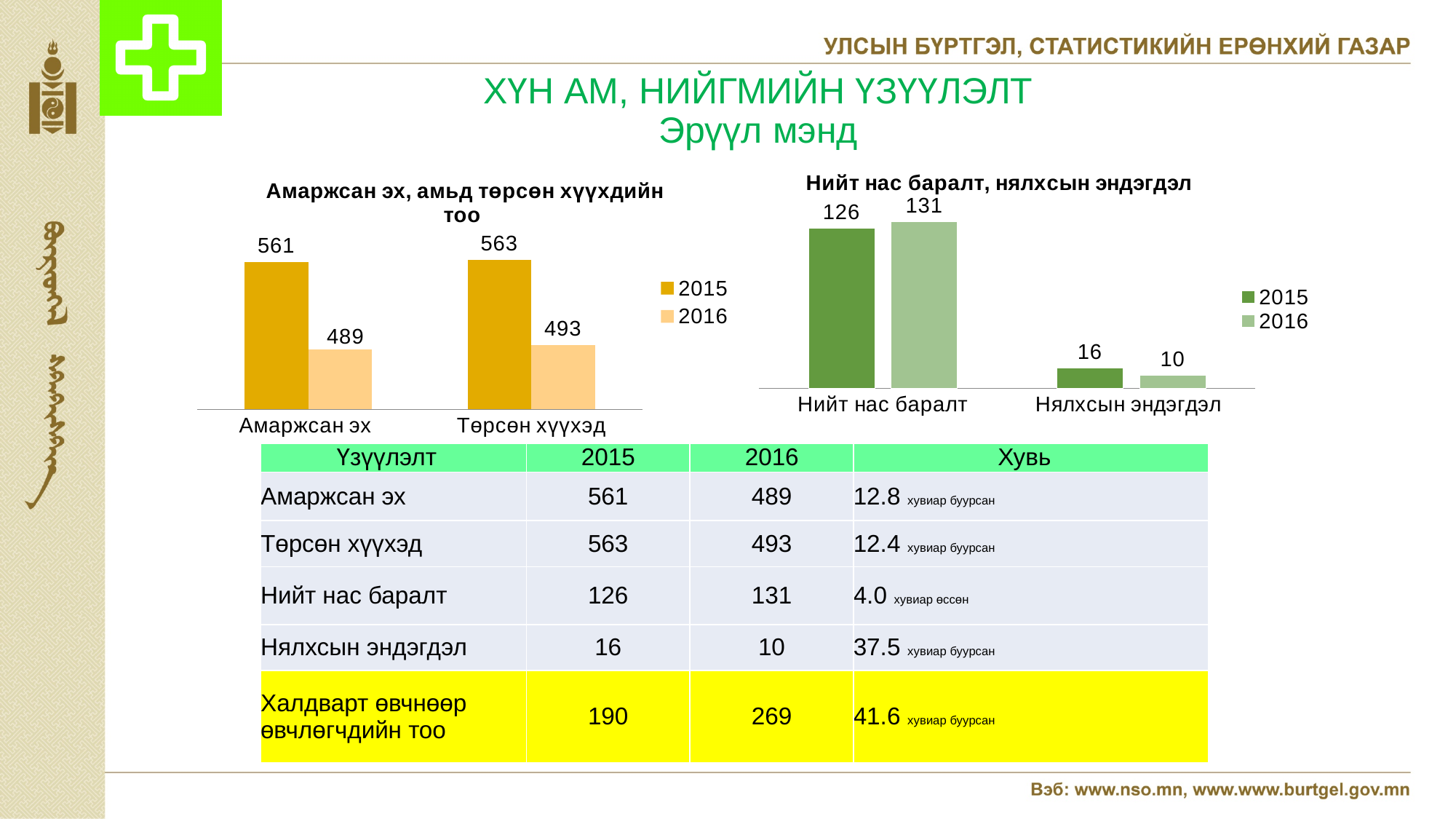
In the left chart (Амаржсан эх, амьд төрсөн хүүхдийн тоо), what is the difference between the 2015 and 2016 values for Амаржсан эх? 72 In the left chart (Амаржсан эх, амьд төрсөн хүүхдийн тоо), how many series does the legend list? 2 In the right chart (Нийт нас баралт, нялхсын эндэгдэл), what is the 2016 value for Нийт нас баралт? 131 In the left chart (Амаржсан эх, амьд төрсөн хүүхдийн тоо), what is the 2015 value for Амаржсан эх? 561 In the right chart (Нийт нас баралт, нялхсын эндэгдэл), what is the 2015 value for Нялхсын эндэгдэл? 16 What kind of chart is the right chart (Нийт нас баралт, нялхсын эндэгдэл)? Bar chart In the right chart (Нийт нас баралт, нялхсын эндэгдэл), which category has the highest 2016 value? Нийт нас баралт In the right chart (Нийт нас баралт, нялхсын эндэгдэл), how many categories are shown on the x axis? 2 In the left chart (Амаржсан эх, амьд төрсөн хүүхдийн тоо), which is larger for Төрсөн хүүхэд: the 2015 value or the 2016 value? 2015 In the right chart (Нийт нас баралт, нялхсын эндэгдэл), what is the difference between the 2015 and 2016 values for Нялхсын эндэгдэл? 6 In the left chart (Амаржсан эх, амьд төрсөн хүүхдийн тоо), what is the 2016 value for Төрсөн хүүхэд? 493 What is the title of the left chart? Амаржсан эх, амьд төрсөн хүүхдийн тоо